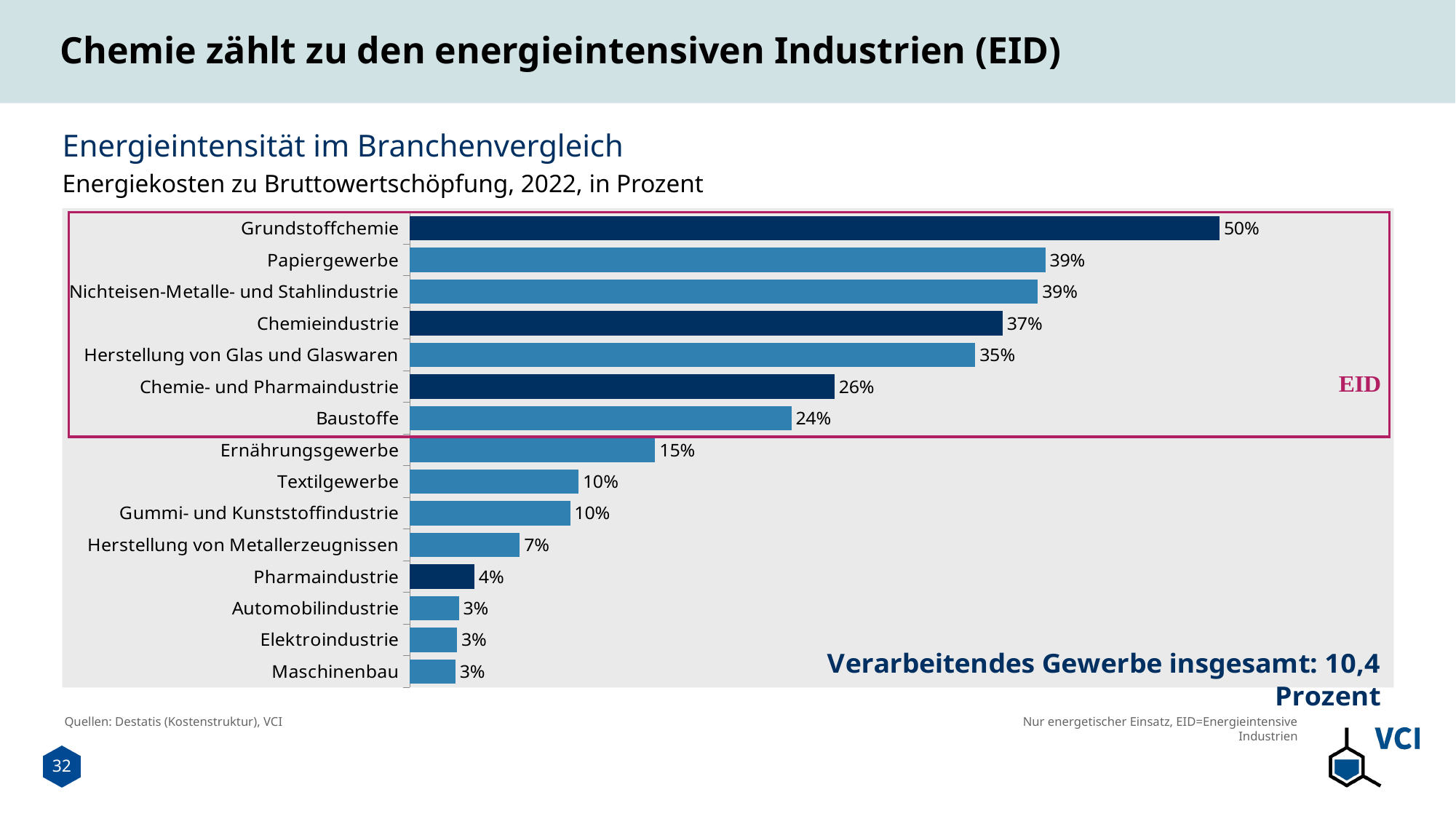
What is the value for Ernährungsgewerbe? 15% How many categories are shown in the chart? 15 What is the value for Chemieindustrie? 37% What is the difference between the values for Grundstoffchemie and Chemieindustrie? 13% What is the value for Grundstoffchemie? 50% Which is larger, the value for Pharmaindustrie or the value for Herstellung von Metallerzeugnissen? Herstellung von Metallerzeugnissen What is the value for Baustoffe? 24% Which category has the highest value? Grundstoffchemie What is the difference between the values for Herstellung von Glas und Glaswaren and Baustoffe? 11% What kind of chart is shown on the slide? Bar chart What is the title of the chart? Energieintensität im Branchenvergleich Which is larger, the value for Chemie- und Pharmaindustrie or the value for Ernährungsgewerbe? Chemie- und Pharmaindustrie